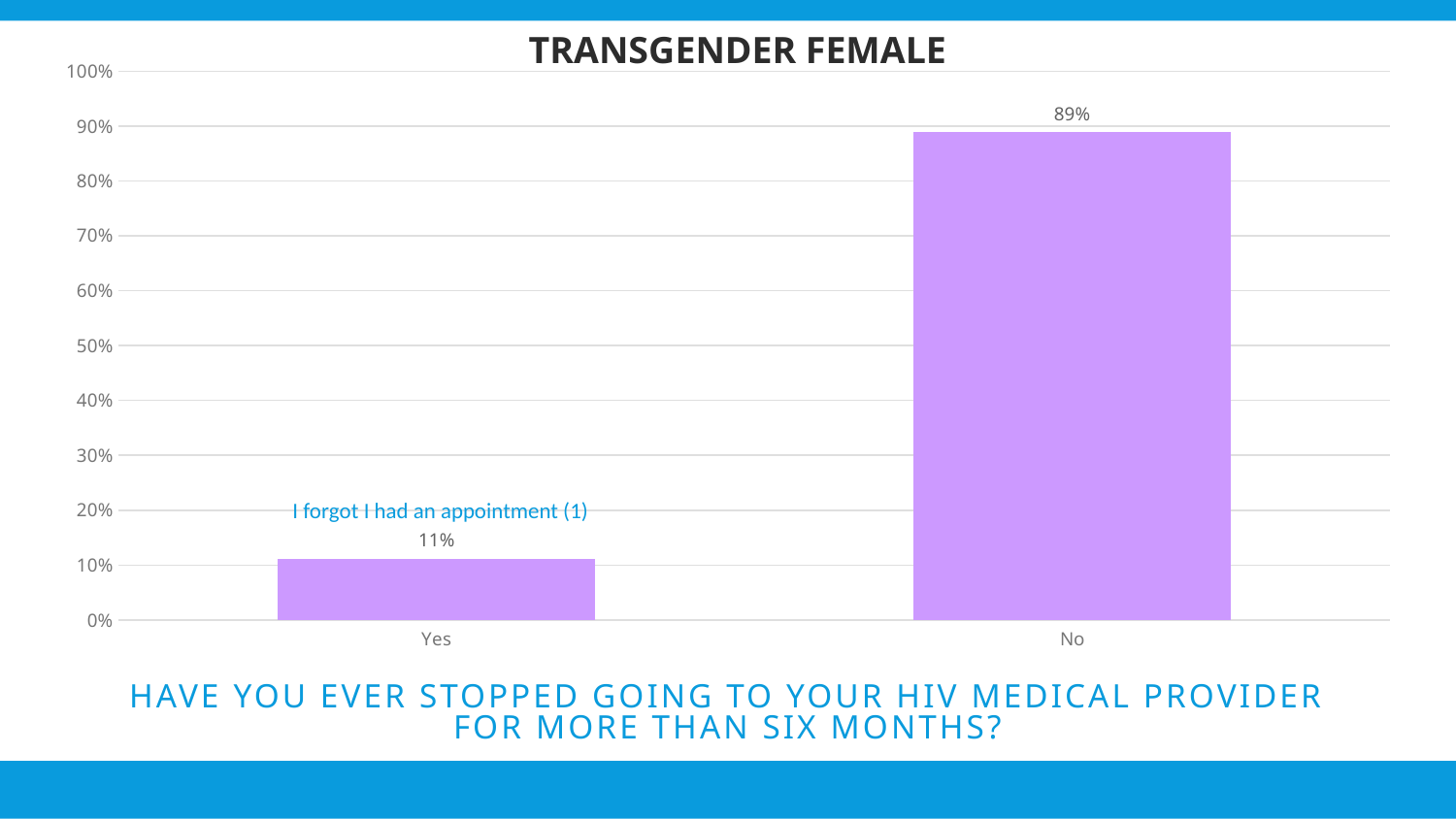
What kind of chart is shown on the slide? bar chart Is the value for "No" greater or less than 80%? greater What is the value for "No"? 89% Which category has the highest value? No Which category has the lowest value? Yes What is the difference between the values for "No" and "Yes"? 78% How many categories are shown on the x axis? 2 What is the value for "Yes"? 11% Which is larger, the value for "Yes" or the value for "No"? No Is the value for "Yes" greater or less than 20%? less What is the title of the chart? TRANSGENDER FEMALE What annotation text is shown above the "Yes" bar? I forgot I had an appointment (1)